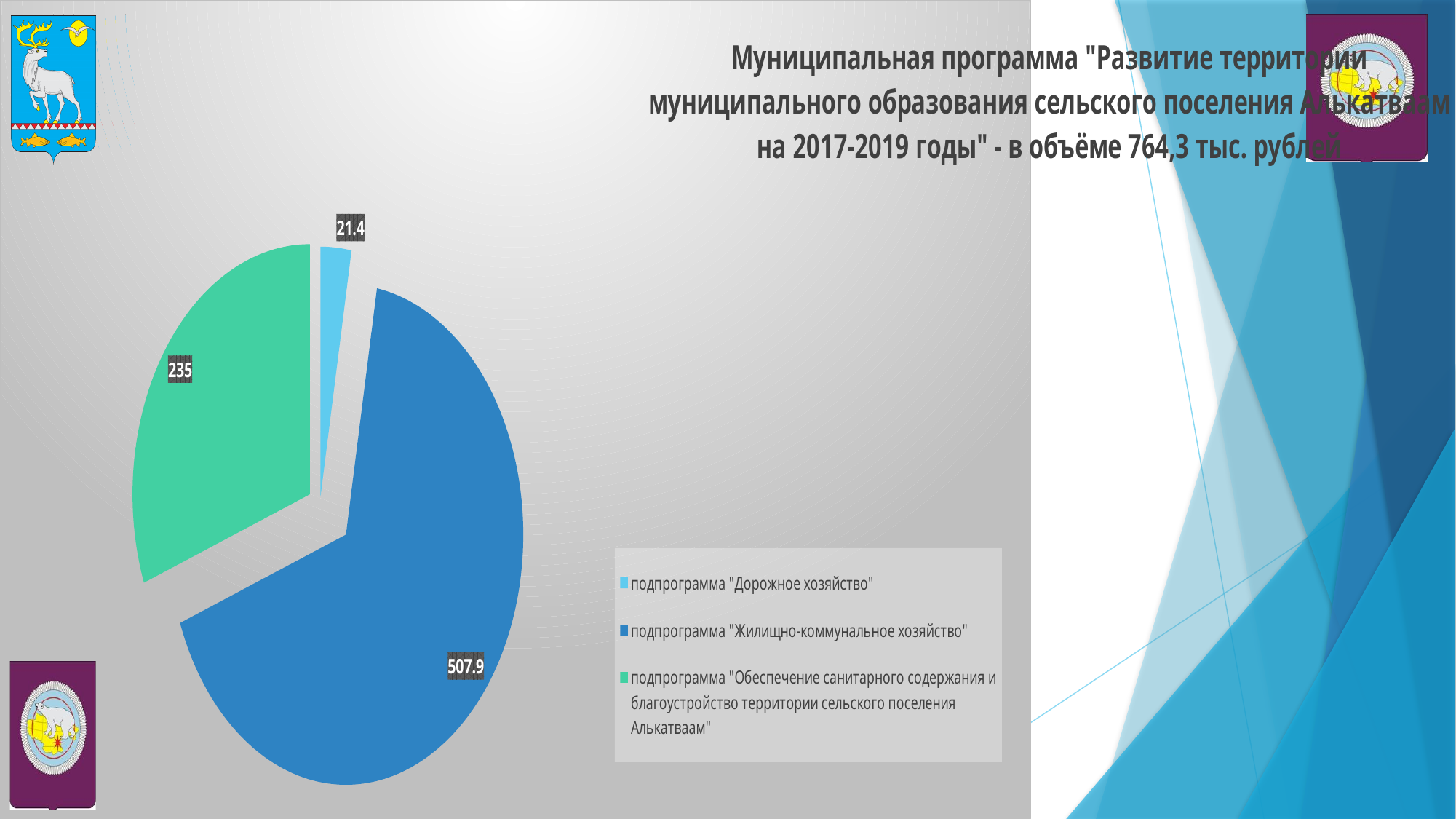
What value is shown for подпрограмма "Дорожное хозяйство"? 21.4 What value is shown for подпрограмма "Жилищно-коммунальное хозяйство"? 507.9 How many slices does the pie chart have? 3 What colour is the slice for подпрограмма "Обеспечение санитарного содержания и благоустройство территории сельского поселения Алькатваам"? green What is the difference between the values for подпрограмма "Жилищно-коммунальное хозяйство" and подпрограмма "Обеспечение санитарного содержания и благоустройство территории сельского поселения Алькатваам"? 272.9 What kind of chart is shown on the slide? pie chart What is the total of all three slices of the pie chart? 764.3 Which is larger: the value for подпрограмма "Дорожное хозяйство" or the value for подпрограмма "Обеспечение санитарного содержания и благоустройство территории сельского поселения Алькатваам"? подпрограмма "Обеспечение санитарного содержания и благоустройство территории сельского поселения Алькатваам" What is the difference between the values for подпрограмма "Обеспечение санитарного содержания и благоустройство территории сельского поселения Алькатваам" and подпрограмма "Дорожное хозяйство"? 213.6 Which subprogram has the smallest slice of the pie? подпрограмма "Дорожное хозяйство" What value is shown for подпрограмма "Обеспечение санитарного содержания и благоустройство территории сельского поселения Алькатваам"? 235 Which subprogram has the largest slice of the pie? подпрограмма "Жилищно-коммунальное хозяйство"